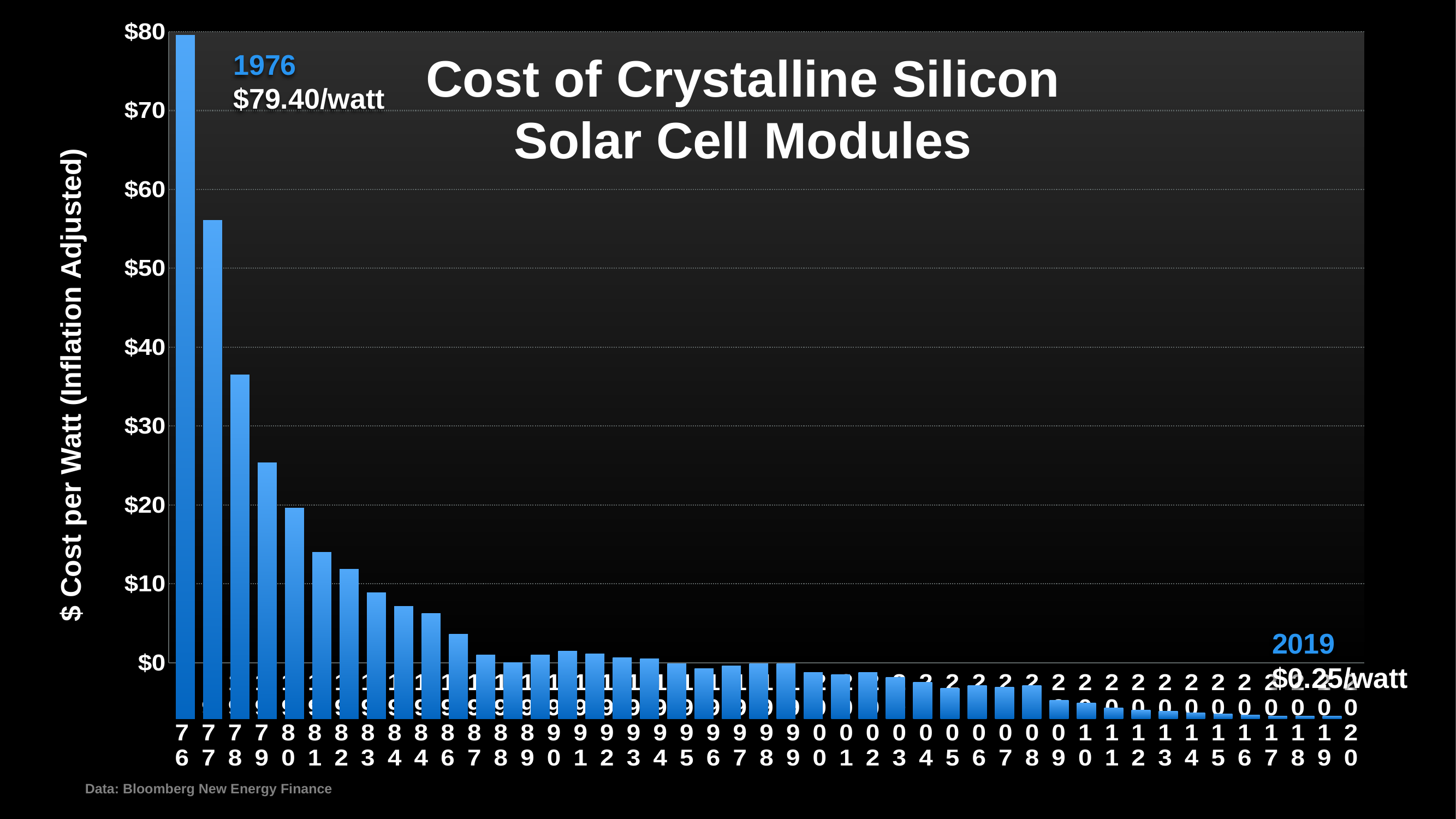
What is the label on the vertical axis? $ Cost per Watt (Inflation Adjusted) Is the value for 1977 greater or less than $50? greater What is the cost per watt shown for 2019? $0.25/watt What is the cost per watt shown for 1976? $79.40/watt Do the values rise or fall from 1976 to 2019? fall What kind of chart is shown on the slide? bar chart What is the title of the chart? Cost of Crystalline Silicon Solar Cell Modules What is the difference between the 1976 cost per watt and the 2019 cost per watt? $79.15/watt Is the value for 1979 greater or less than $20? greater Is the value for 1986 greater or less than $10? less Which year has the highest cost per watt? 1976 Which is larger, the value for 1977 or the value for 1978? 1977